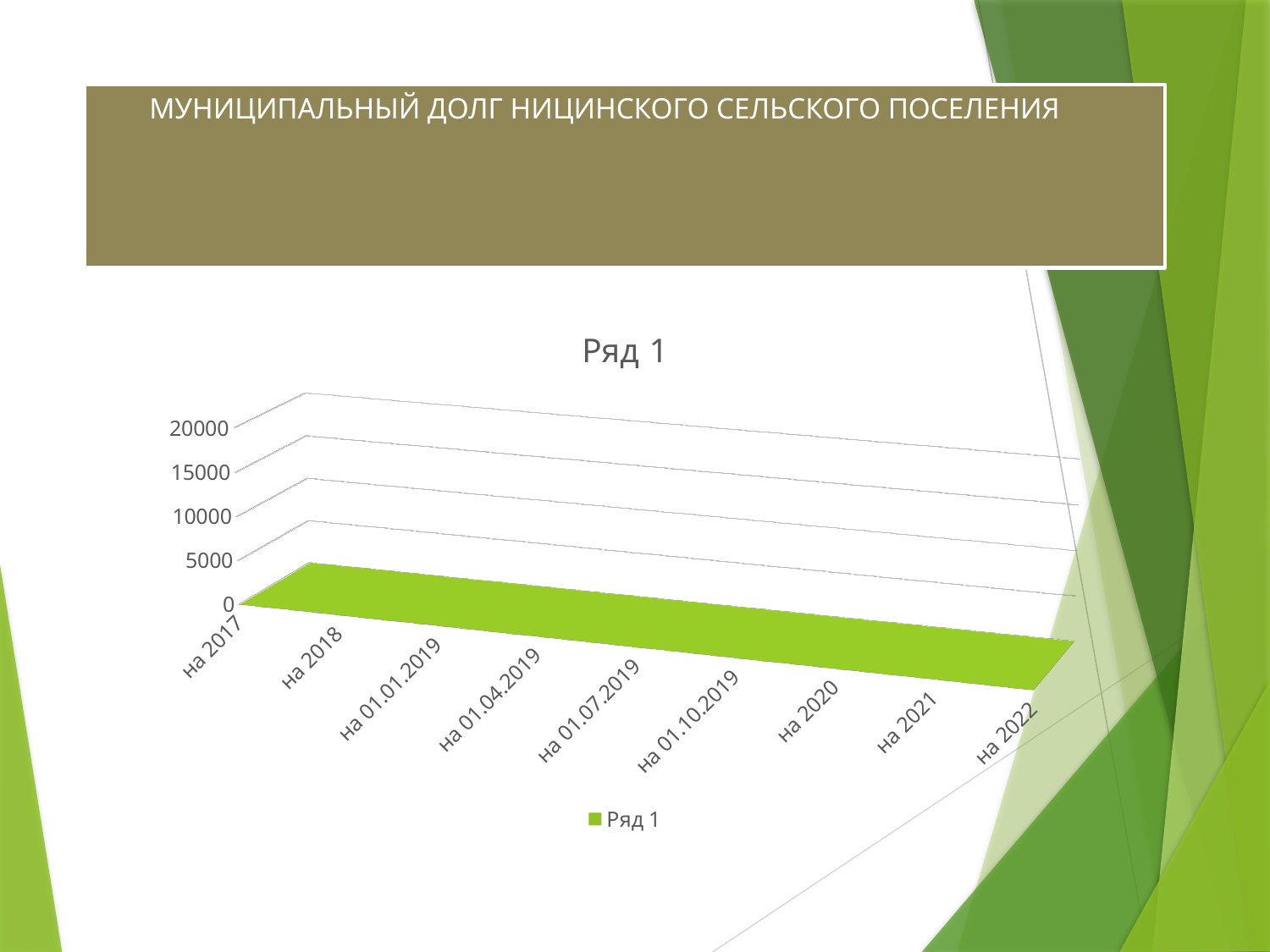
What is the name of the series shown in the legend? Ряд 1 How many categories are shown along the x axis of the chart? 9 Is the value for на 2017 greater or less than 5000? less What is the last category on the x axis? на 2022 What kind of chart is shown on the slide? area chart What is the first category on the x axis? на 2017 Do the values rise, fall, or stay flat from на 2017 to на 2022? stay flat Is the value for на 01.07.2019 greater or less than 10000? less Is the value for на 2022 greater or less than 5000? less What is the title of the chart? Ряд 1 How many series does the chart legend list? 1 What is the highest value shown on the vertical axis? 20000